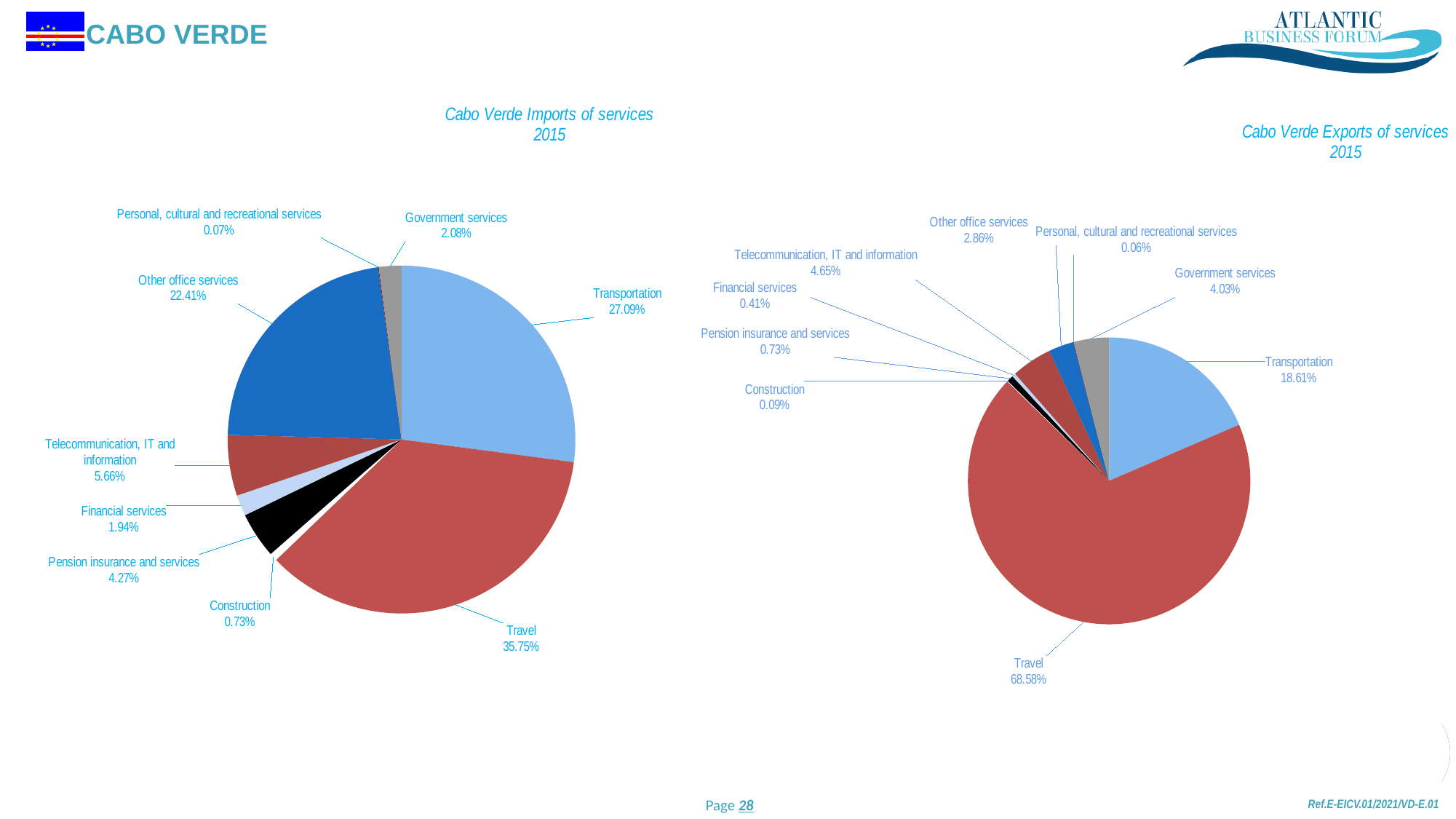
In the Cabo Verde Exports of services 2015 chart, which category has the smallest share? Personal, cultural and recreational services In the Cabo Verde Imports of services 2015 chart, which category has the smallest share? Personal, cultural and recreational services In the Cabo Verde Imports of services 2015 chart, what is the value for Other office services? 22.41% In the Cabo Verde Imports of services 2015 chart, which is larger: Transportation or Other office services? Transportation What type of chart is the Cabo Verde Imports of services 2015 chart? Pie chart In the Cabo Verde Imports of services 2015 chart, what is the difference between Telecommunication, IT and information and Financial services? 3.72% In the Cabo Verde Imports of services 2015 chart, what share does Travel have? 35.75% In the Cabo Verde Exports of services 2015 chart, what is the difference between the Travel and Transportation shares? 49.97% In the Cabo Verde Exports of services 2015 chart, what share does Transportation have? 18.61% In the Cabo Verde Imports of services 2015 chart, which category has the largest share? Travel How many categories are shown in the Cabo Verde Exports of services 2015 pie chart? 9 In the Cabo Verde Exports of services 2015 chart, what is the value for Telecommunication, IT and information? 4.65%